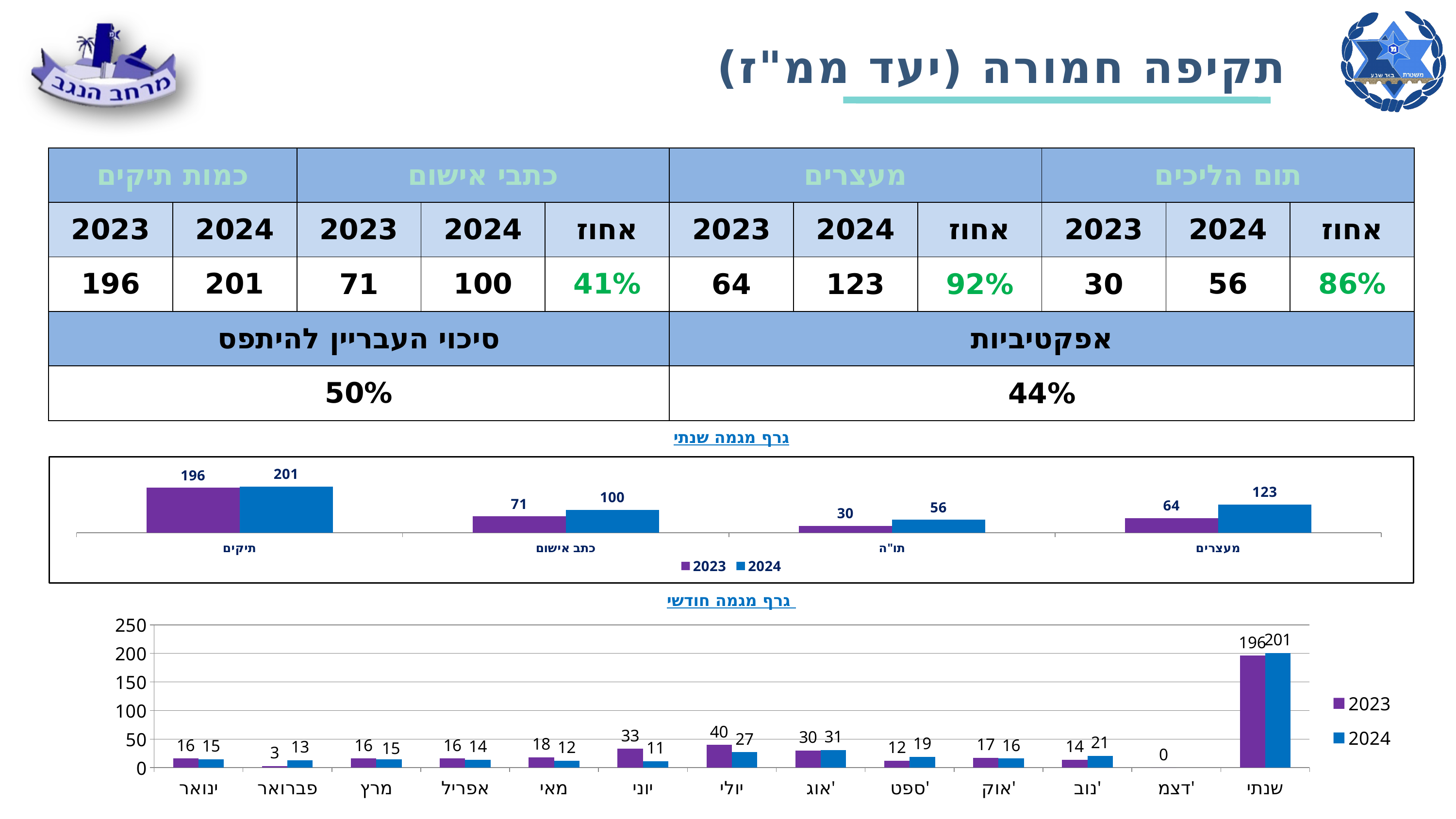
In the annual trend chart (גרף מגמה שנתי), what is the 2023 value for כתב אישום? 71 In the annual trend chart (גרף מגמה שנתי), what is the 2024 value for מעצרים? 123 In the monthly trend chart (גרף מגמה חודשי), what is the difference between the 2023 and 2024 values for יוני? 22 In the monthly trend chart (גרף מגמה חודשי), what is the 2024 value for פברואר? 13 In the annual trend chart (גרף מגמה שנתי), which category has the highest 2024 value? תיקים In the monthly trend chart (גרף מגמה חודשי), what is the 2023 value for יולי? 40 In the monthly trend chart (גרף מגמה חודשי), is the 2023 value for יוני larger or the 2024 value? 2023 What kind of chart is the monthly trend chart (גרף מגמה חודשי)? bar chart In the annual trend chart (גרף מגמה שנתי), how many series does the legend list? 2 In the monthly trend chart (גרף מגמה חודשי), which month has the highest 2023 value (excluding שנתי)? יולי In the annual trend chart (גרף מגמה שנתי), which category has the lowest 2023 value? תו"ה In the annual trend chart (גרף מגמה שנתי), what is the difference between the 2024 and 2023 values for מעצרים? 59